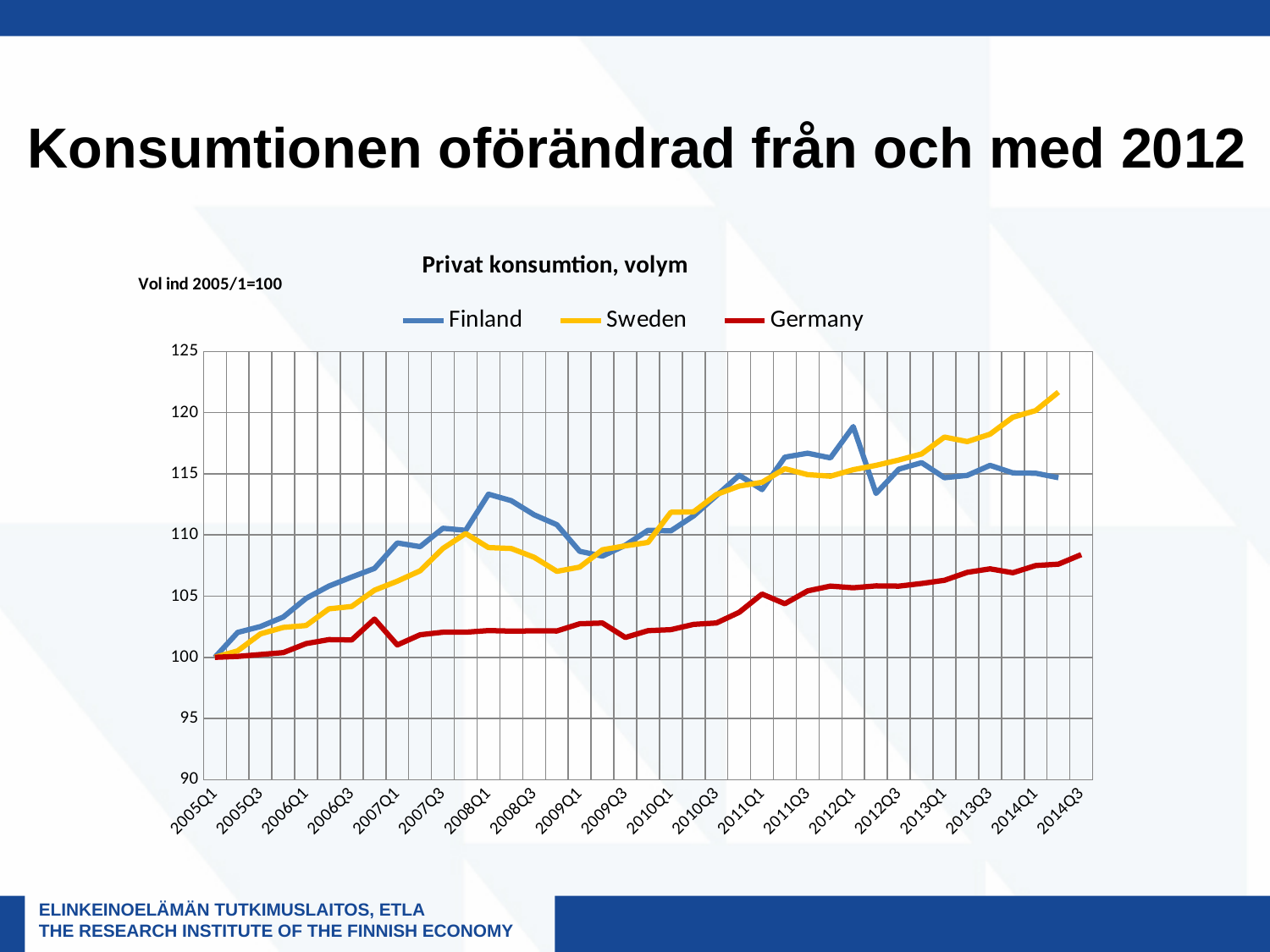
Is the value for Finland at 2012Q1 greater or less than 115? greater Does the Germany line generally rise or fall from 2005Q1 to 2014Q3? rise What is the title of the chart? Privat konsumtion, volym How many series does the legend of the chart list? 3 Is the value for Germany at 2014Q3 greater or less than 110? less What kind of chart is shown on the slide? line chart Which series is lowest at 2014Q3? Germany At 2008Q1, which is higher, Finland or Sweden? Finland Is the value for Germany at 2009Q3 greater or less than 105? less